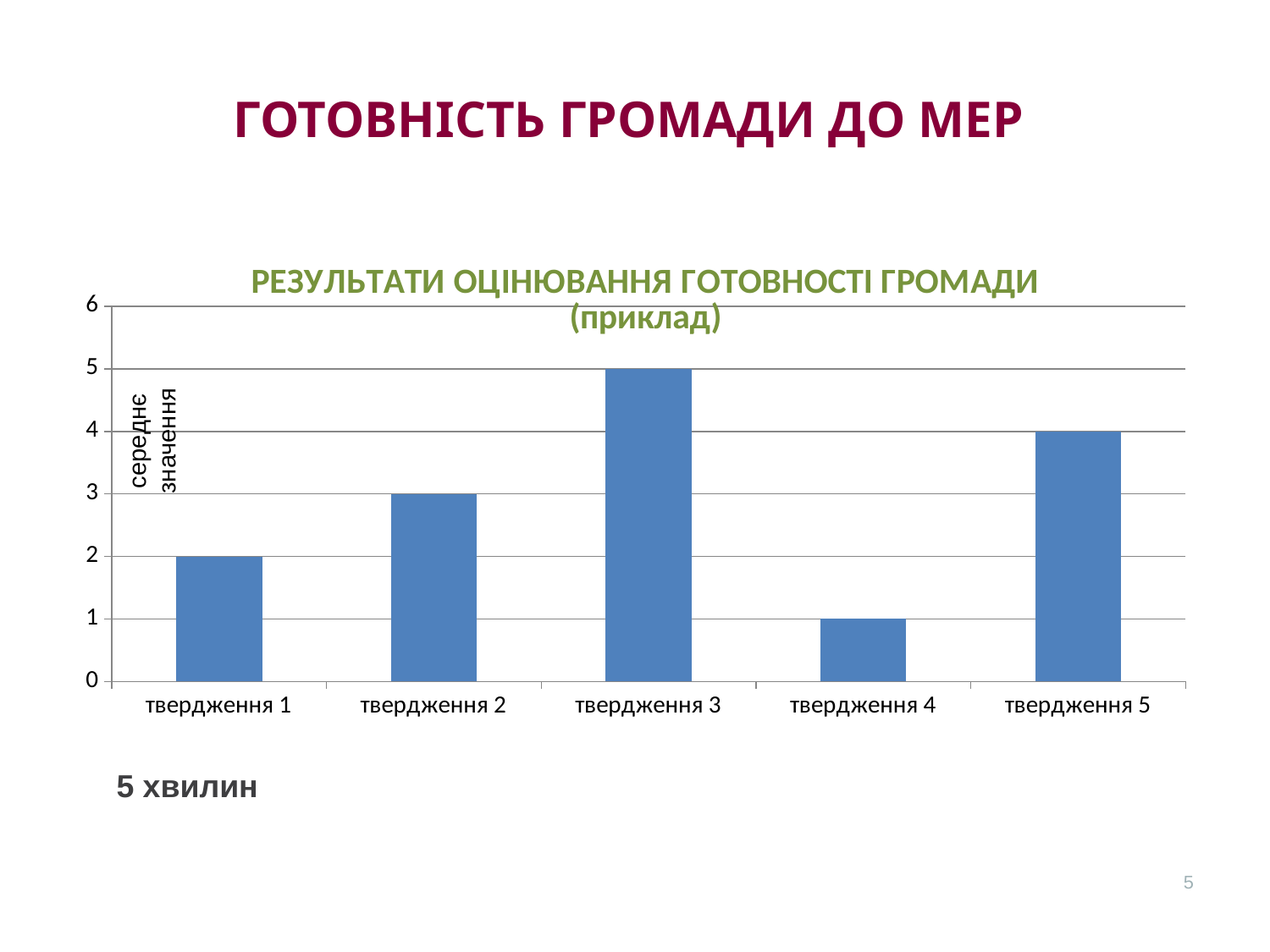
Which is larger, the value for твердження 2 or the value for твердження 5? твердження 5 Which category has the lowest value? твердження 4 What is the difference between the values for твердження 5 and твердження 2? 1 What is the value for твердження 3? 5 What is the value for твердження 1? 2 How many categories are shown on the x axis? 5 What is the difference between the values for твердження 3 and твердження 4? 4 What kind of chart is shown on the slide? bar chart Is the value for твердження 4 greater or less than 2? less What is the label of the vertical axis? середнє значення Which category has the highest value? твердження 3 What is the value for твердження 5? 4